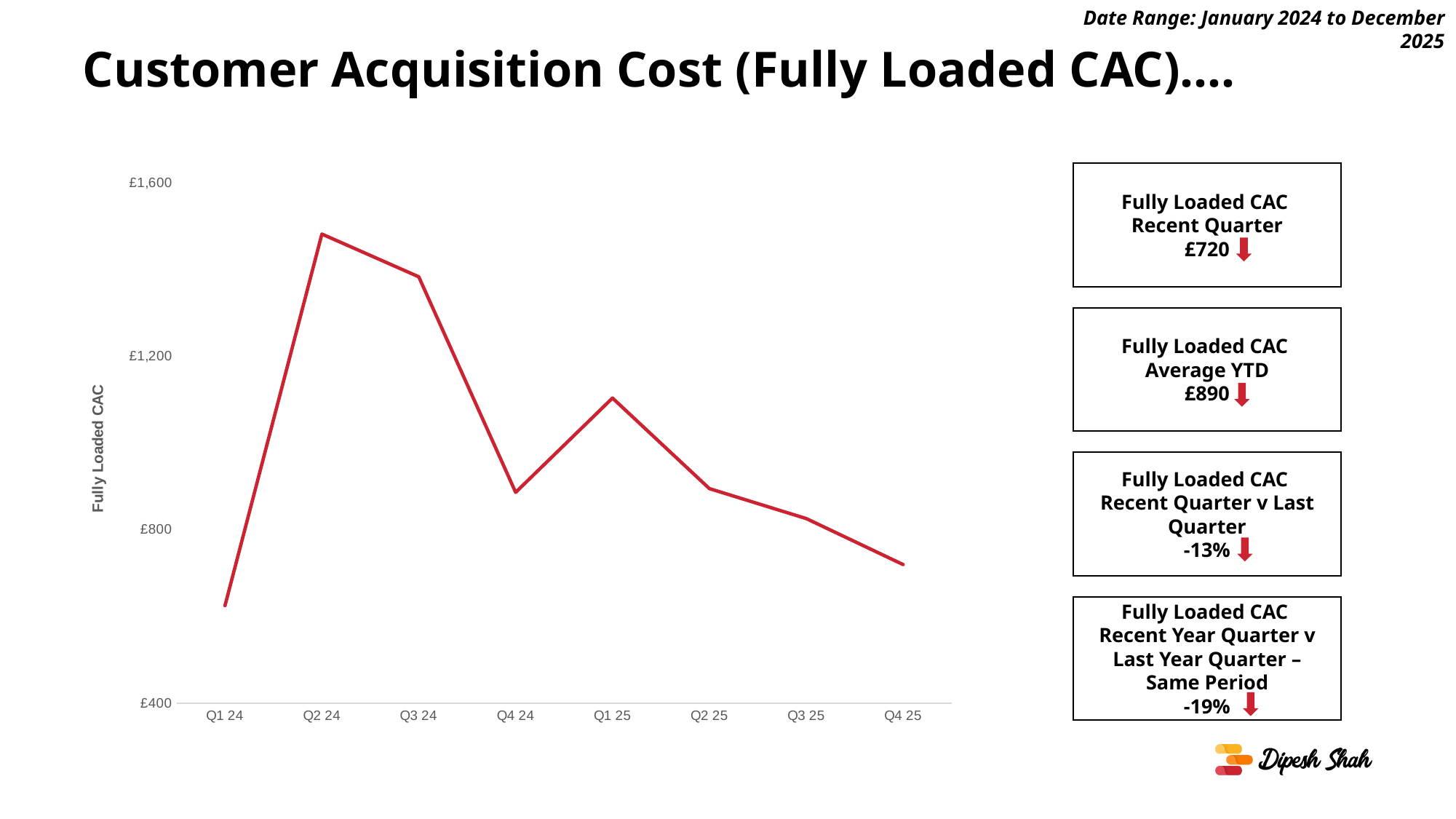
Is the value for Q2 24 greater or less than £1,200? greater Which quarter has the highest Fully Loaded CAC on the chart? Q2 24 Which is larger, the value for Q4 24 or the value for Q1 25? Q1 25 Which quarter has the lowest Fully Loaded CAC on the chart? Q1 24 What kind of chart is shown on the slide? line chart Is the value for Q1 25 greater or less than £1,200? less What is the label on the y axis of the chart? Fully Loaded CAC Is the value for Q4 25 greater or less than £800? less Do the values rise or fall from Q1 25 to Q4 25? fall How many quarters are plotted on the x axis of the chart? 8 What is the Fully Loaded CAC for the most recent quarter, as stated in the box on the slide? £720